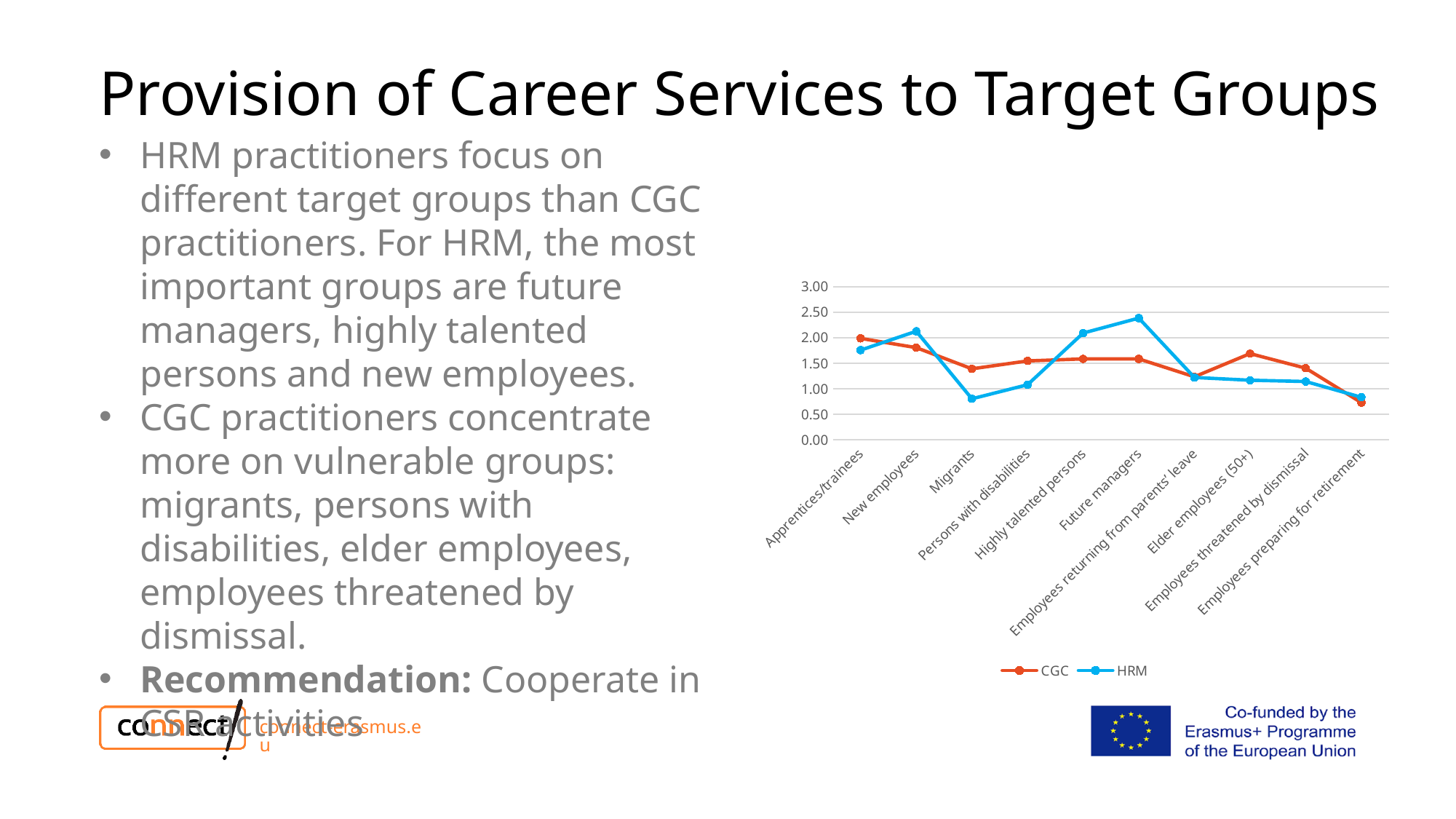
For Migrants, which series has the larger value, CGC or HRM? CGC Do the HRM values rise or fall from Persons with disabilities to Future managers? rise For which target group is the CGC value highest? Apprentices/trainees Is the HRM value for Future managers greater or less than 2.00? greater For Future managers, which series has the larger value, CGC or HRM? HRM What kind of chart is shown on the slide? Line chart For which target group is the CGC value lowest? Employees preparing for retirement Is the HRM value for Migrants greater or less than 1.00? less Which series are listed in the chart legend? CGC and HRM How many series does the chart legend list? 2 For which target group is the HRM value highest? Future managers How many target group categories are plotted along the x axis? 10